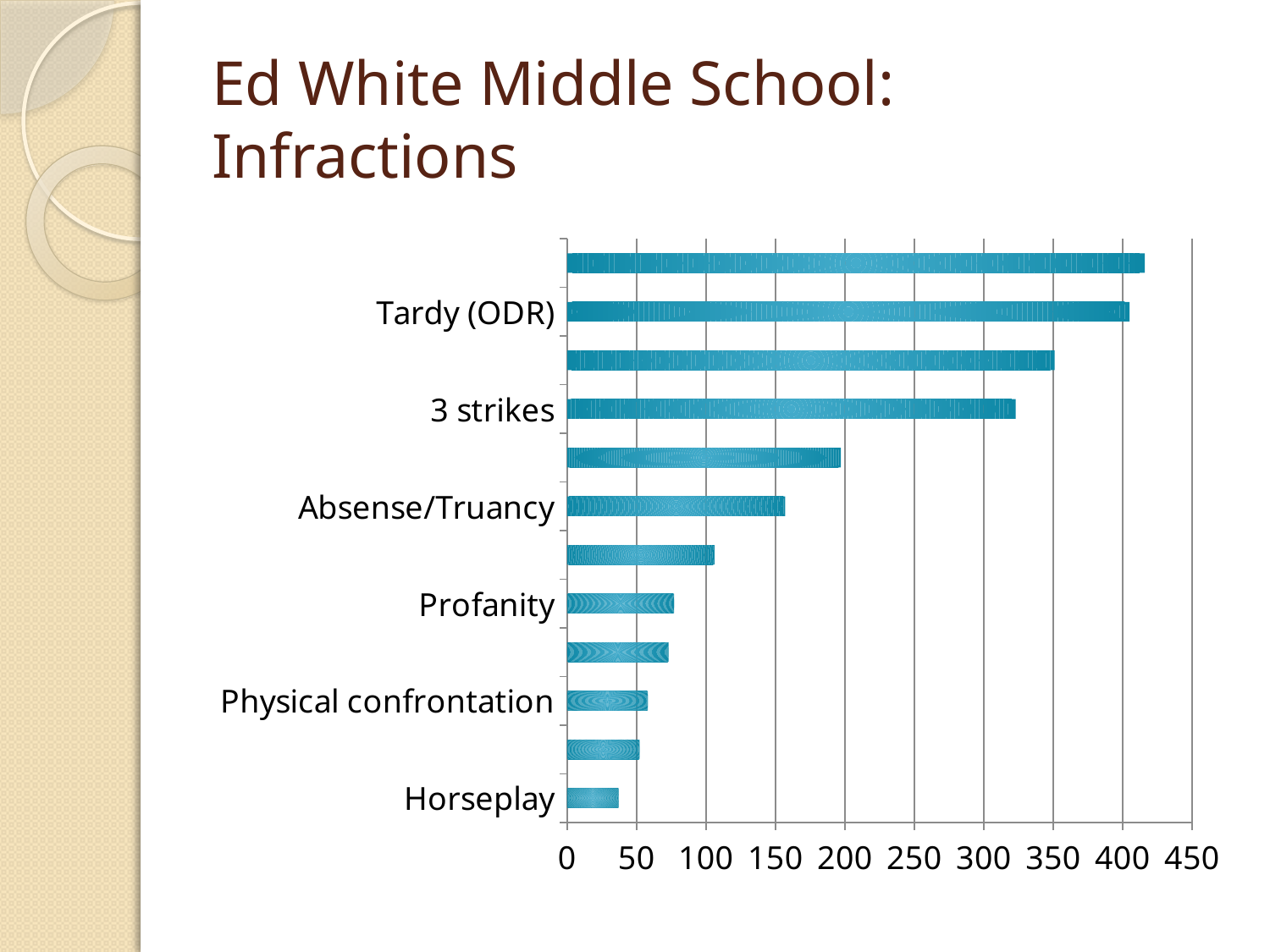
Which is larger, the value for Tardy (ODR) or the value for 3 strikes? Tardy (ODR) Which category has the lowest value in the chart? Horseplay What kind of chart is shown on the slide? bar chart How many bars does the chart contain? 12 What is the title of the slide containing the chart? Ed White Middle School: Infractions Is the value for Absense/Truancy greater or less than 200? less Is the value for Horseplay greater or less than 50? less Is the value for Physical confrontation greater or less than 100? less